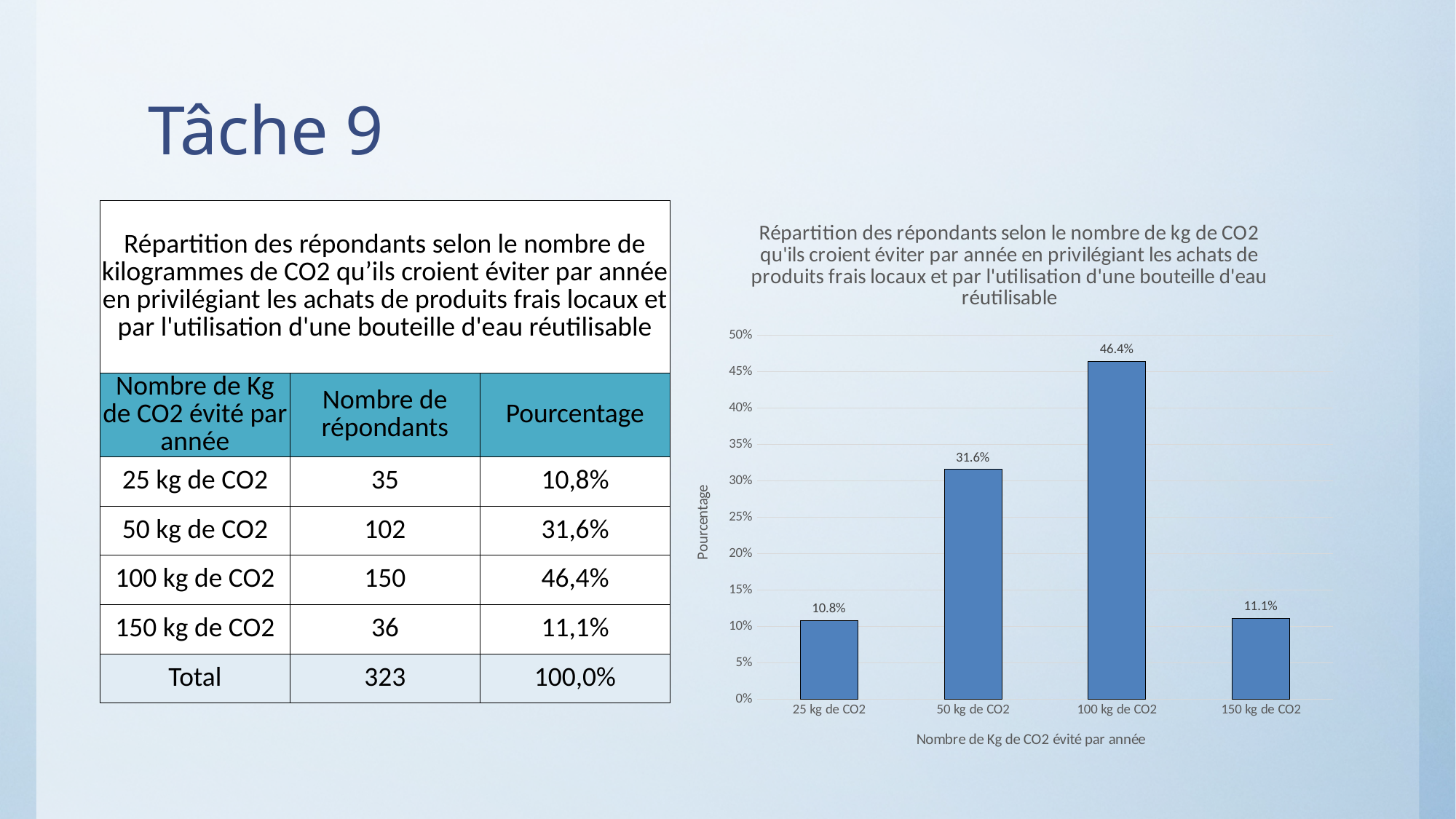
Which is larger in the bar chart: the value for 50 kg de CO2 or the value for 150 kg de CO2? 50 kg de CO2 How many categories are shown on the x axis of the bar chart? 4 What kind of chart is shown on the slide? bar chart Which category has the highest value in the bar chart? 100 kg de CO2 What is the label of the y axis of the bar chart? Pourcentage What is the value for 150 kg de CO2 in the bar chart? 11.1% What is the value for 100 kg de CO2 in the bar chart? 46.4% What is the value for 25 kg de CO2 in the bar chart? 10.8% What is the difference between the values for 100 kg de CO2 and 50 kg de CO2 in the bar chart? 14.8% Is the value for 100 kg de CO2 in the bar chart greater or less than 40%? greater What is the value for 50 kg de CO2 in the bar chart? 31.6% Which category has the lowest value in the bar chart? 25 kg de CO2